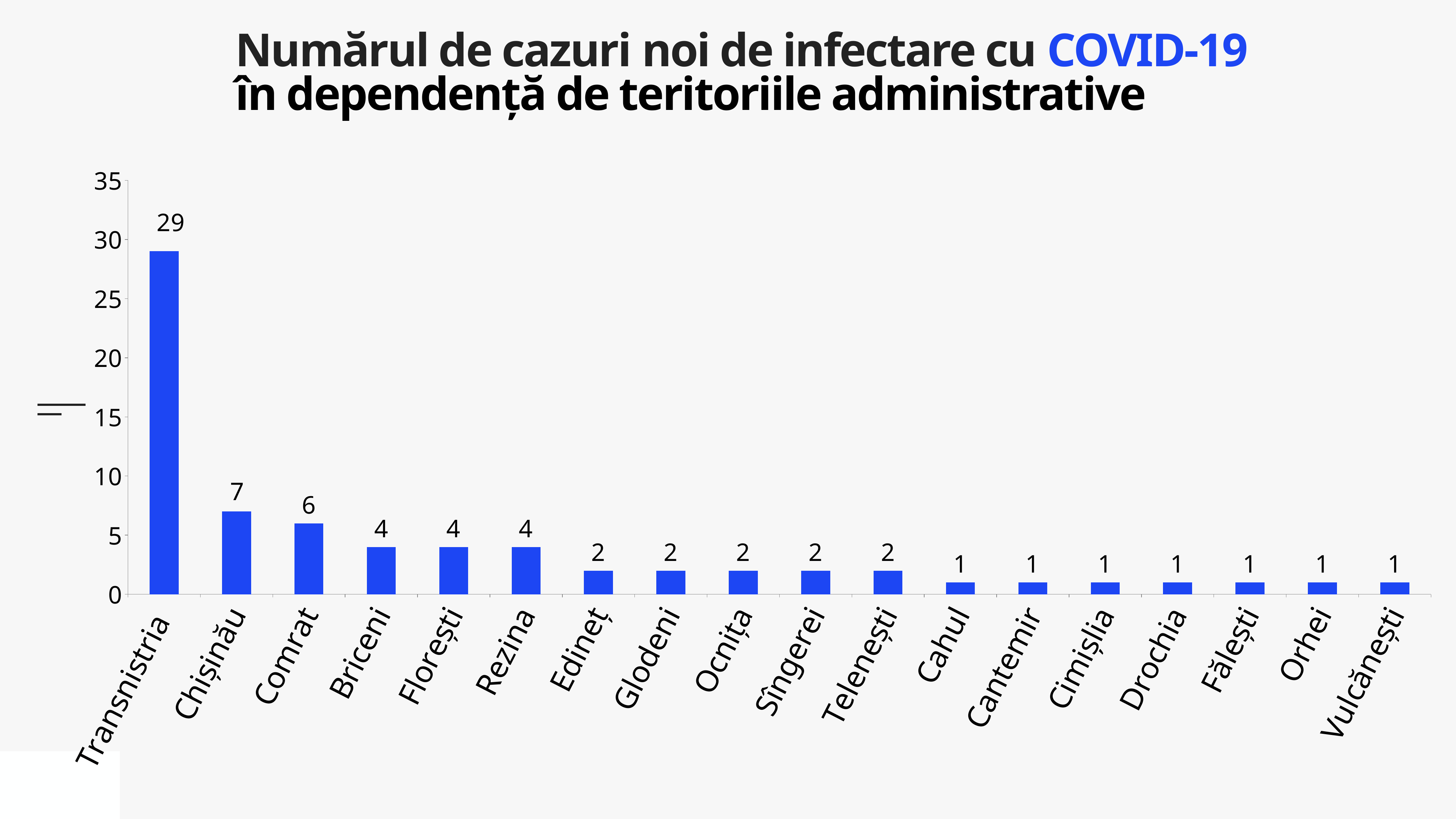
What is the difference between the values for Transnistria and Chișinău? 22 How many territories are shown on the x axis? 18 What is the difference between the values for Comrat and Briceni? 2 Is the value for Transnistria greater or less than 25? greater What is the value for Transnistria? 29 Do the values rise or fall from left to right along the x axis? fall What kind of chart is shown on the slide? bar chart What is the value for Edineț? 2 Which is larger, the value for Rezina or the value for Cahul? Rezina Which territory has the highest number of new cases? Transnistria What is the value for Chișinău? 7 What is the value for Comrat? 6